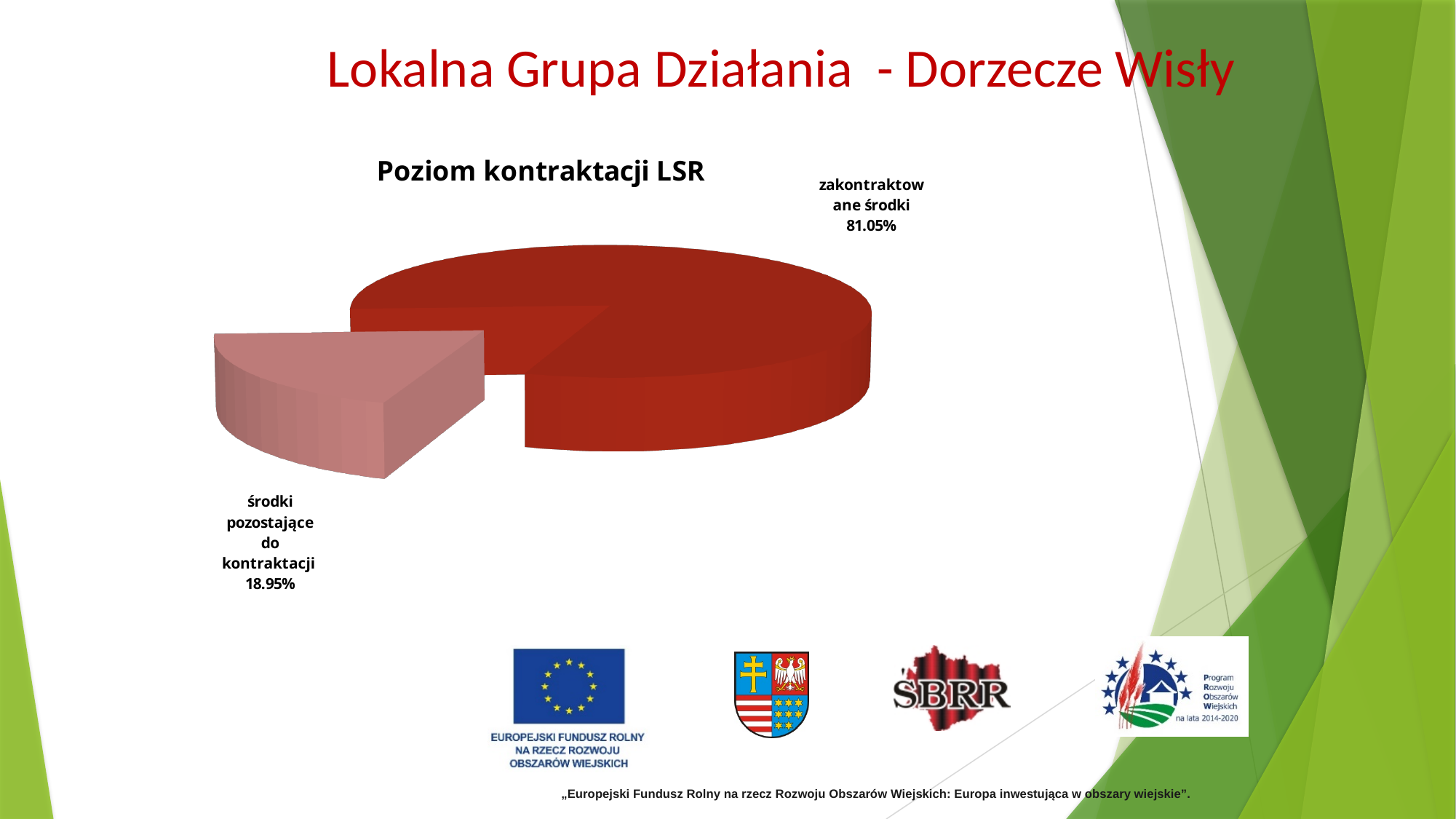
What colour is the slice for 'środki pozostające do kontraktacji'? pink Which slice of the pie is the smallest? środki pozostające do kontraktacji What share of the pie is labelled 'środki pozostające do kontraktacji'? 18.95% What share of the pie is labelled 'zakontraktowane środki'? 81.05% What is the difference in percentage points between 'zakontraktowane środki' and 'środki pozostające do kontraktacji'? 62.1 What is the title of the chart? Poziom kontraktacji LSR How many slices does the pie chart have? 2 What kind of chart is shown on the slide? pie chart Which is larger: 'zakontraktowane środki' or 'środki pozostające do kontraktacji'? zakontraktowane środki Which slice of the pie is the largest? zakontraktowane środki